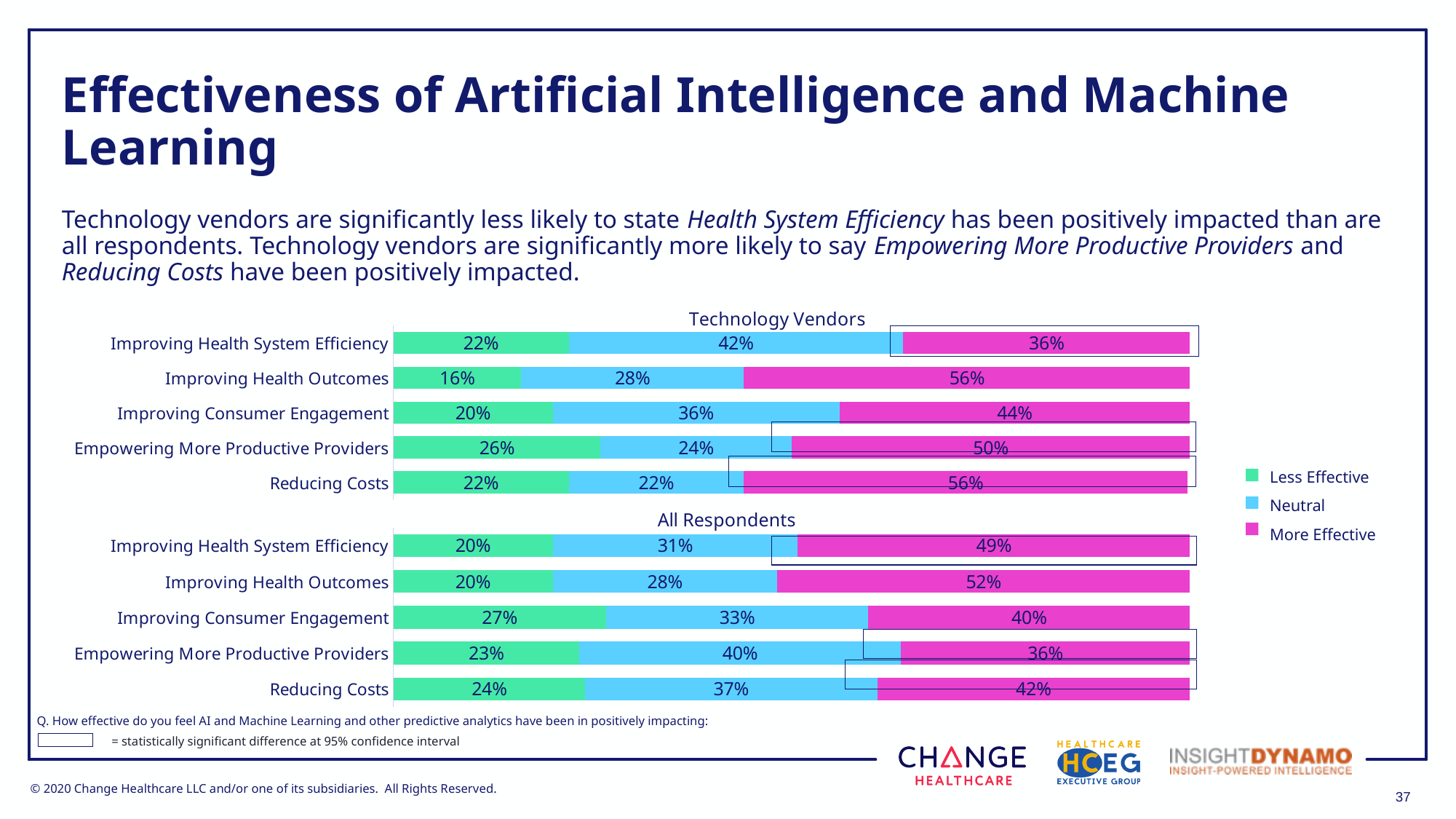
In the Technology Vendors chart, what is the Less Effective value for Empowering More Productive Providers? 26% Which is larger: the More Effective value for Reducing Costs in the Technology Vendors chart or in the All Respondents chart? Technology Vendors What type of chart is used for the Technology Vendors data? Stacked bar chart In the All Respondents chart, what is the total of the Less Effective and Neutral values for Improving Consumer Engagement? 60% In the All Respondents chart, which category has the highest More Effective value? Improving Health Outcomes Which colour represents the Neutral series in the legend? Blue In the Technology Vendors chart, which category has the lowest Less Effective value? Improving Health Outcomes How many categories are shown in the All Respondents chart? 5 How many series does the legend list? 3 In the Technology Vendors chart, what is the difference between the Neutral values for Improving Health System Efficiency and Reducing Costs? 20% In the Technology Vendors chart, what percentage of respondents rated Improving Health Outcomes as More Effective? 56% In the All Respondents chart, what is the Neutral value for Empowering More Productive Providers? 40%